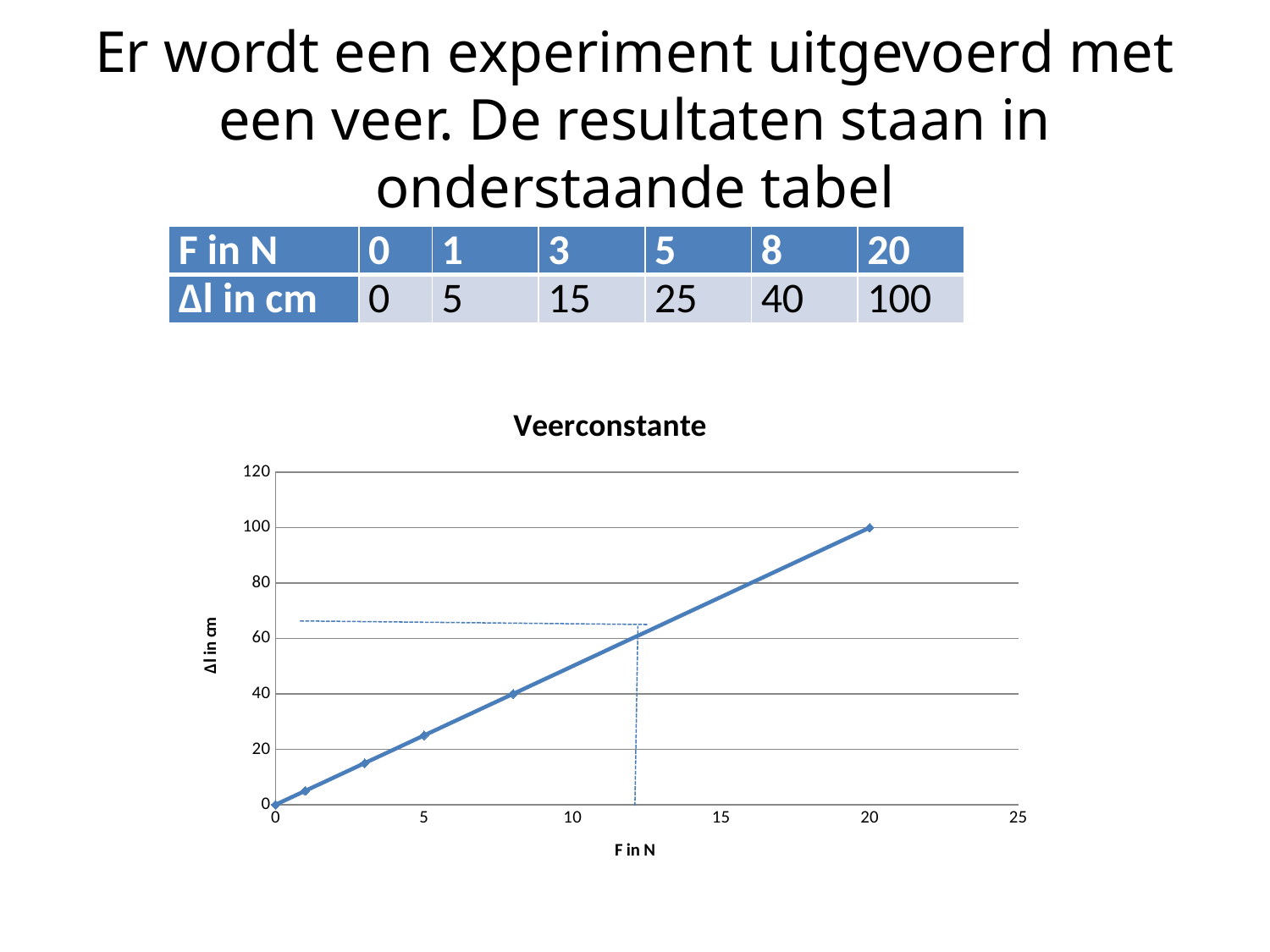
What is the value of Δl in cm when F is 3 N? 15 At which value of F in N is Δl the lowest? 0 Do the values of Δl rise or fall as F increases along the x axis? rise What is the title of the chart? Veerconstante What is the difference in Δl between F = 20 N and F = 8 N? 60 What is the label of the x axis of the chart? F in N How many data points are plotted on the chart? 6 At which value of F in N is Δl the highest? 20 Is Δl larger at F = 5 N or at F = 8 N? 8 N What is the value of Δl in cm when F is 20 N? 100 What is the value of Δl in cm when F is 8 N? 40 What kind of chart is shown on the slide? line chart